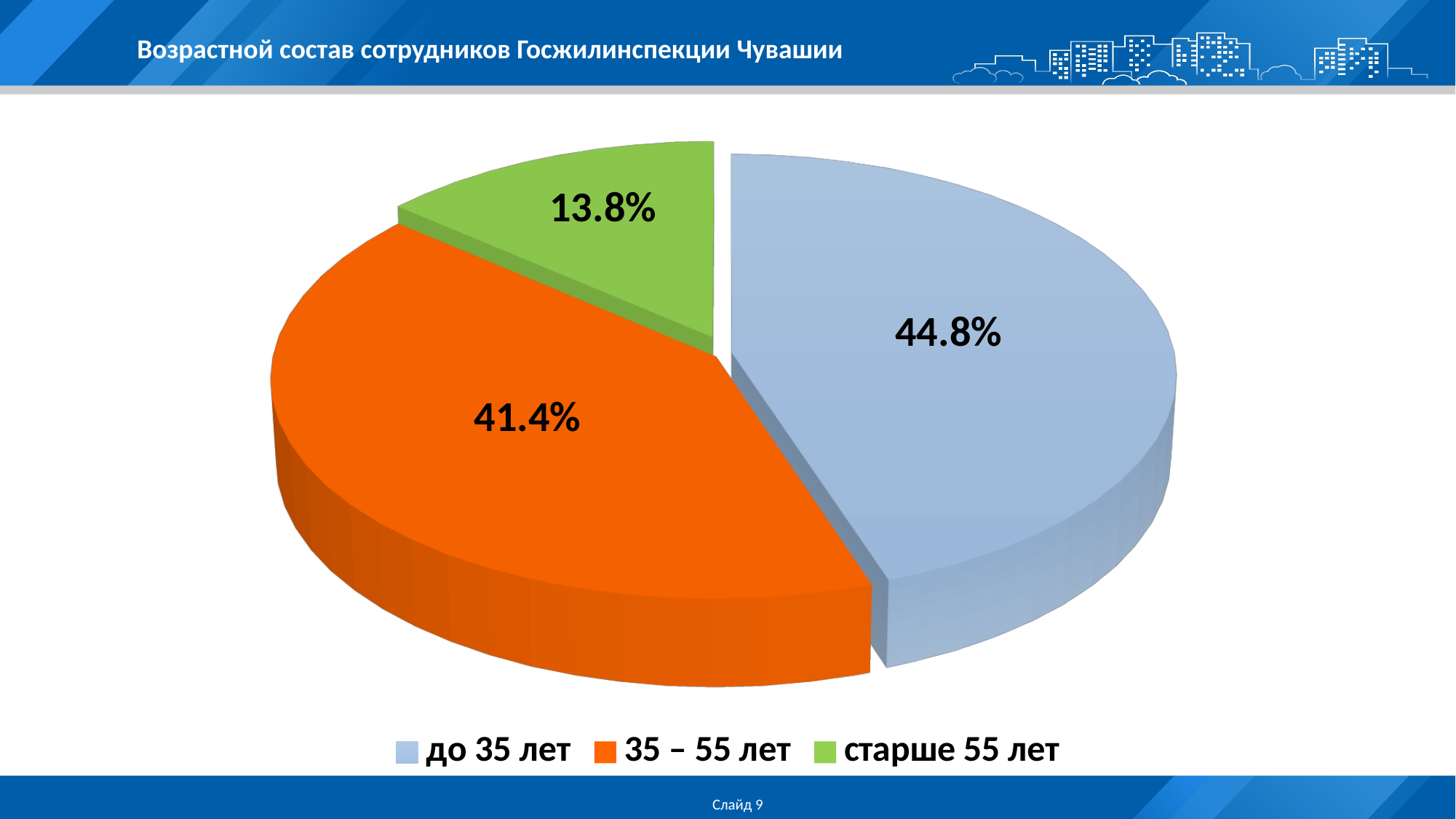
What is the title of the slide? Возрастной состав сотрудников Госжилинспекции Чувашии What is the difference in percentage points between the 'до 35 лет' and '35 – 55 лет' shares? 3.4 What share of employees are in the '35 – 55 лет' category? 41.4% What share of employees are in the 'до 35 лет' category? 44.8% Which age category has the largest share? до 35 лет What is the difference in percentage points between the '35 – 55 лет' and 'старше 55 лет' shares? 27.6 What share of employees are in the 'старше 55 лет' category? 13.8% How many entries does the legend list? 3 What kind of chart is shown on the slide? Pie chart How many age categories does the pie chart show? 3 Which age category has the smallest share? старше 55 лет Which is larger: the share for 'до 35 лет' or for 'старше 55 лет'? до 35 лет